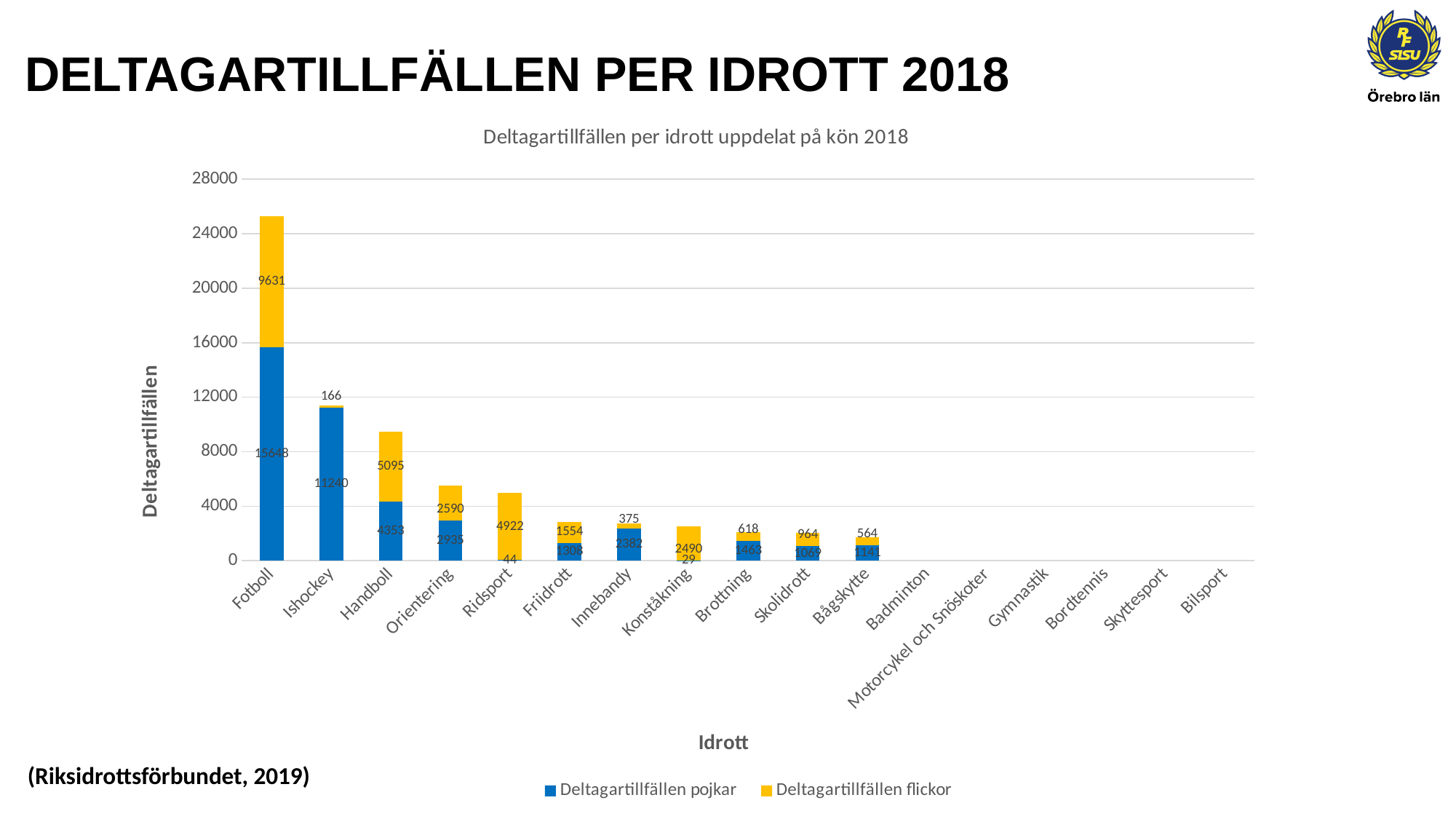
What is the value of Deltagartillfällen pojkar for Innebandy? 2382 What is the difference between Deltagartillfällen flickor and Deltagartillfällen pojkar for Handboll? 742 Is the total value for Ishockey greater or less than 8000? greater What is the total of the stacked bar for Handboll? 9448 What is the value of Deltagartillfällen flickor for Ridsport? 4922 How many series does the legend list? 2 What is the value of Deltagartillfällen flickor for Fotboll? 9631 Which sport has the highest total number of deltagartillfällen? Fotboll For Orientering, which is larger: Deltagartillfällen pojkar or Deltagartillfällen flickor? Deltagartillfällen pojkar What kind of chart is shown on the slide? Stacked bar chart How many sports (categories) are listed along the x axis? 17 What is the value of Deltagartillfällen pojkar for Ishockey? 11240